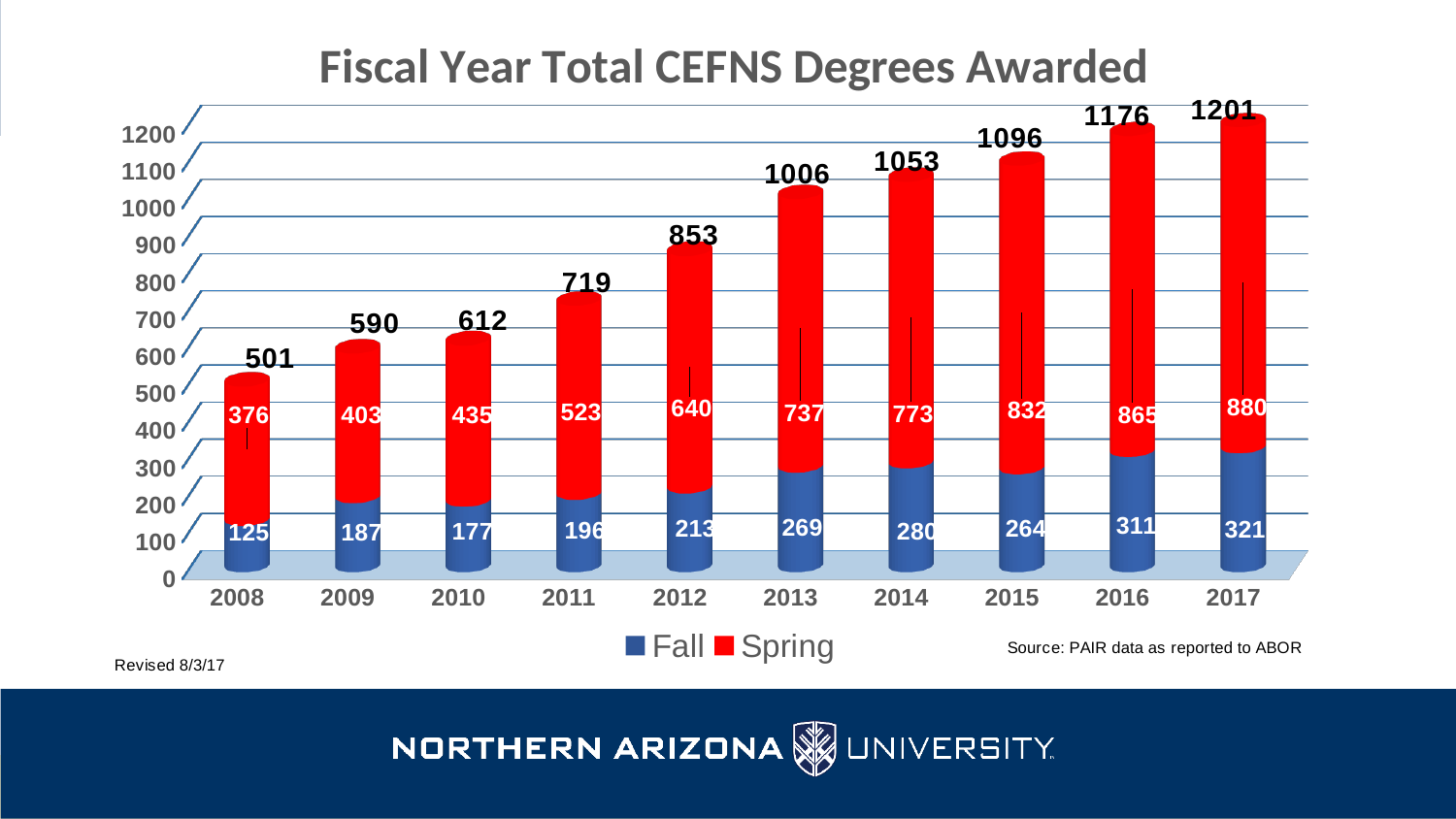
What kind of chart is this? Stacked bar chart What is the title of the chart? Fiscal Year Total CEFNS Degrees Awarded Do the total degrees awarded rise or fall from 2008 to 2017? Rise How many series does the legend list? 2 Which year has the lowest Fall value? 2008 Which is larger, the Fall value for 2014 or the Fall value for 2015? 2014 What is the Spring value for 2010? 435 What is the total number of degrees awarded in 2012? 853 What is the Fall value for 2013? 269 How many years are shown on the x axis? 10 What is the difference between the Spring values for 2017 and 2008? 504 Which year has the highest total degrees awarded? 2017